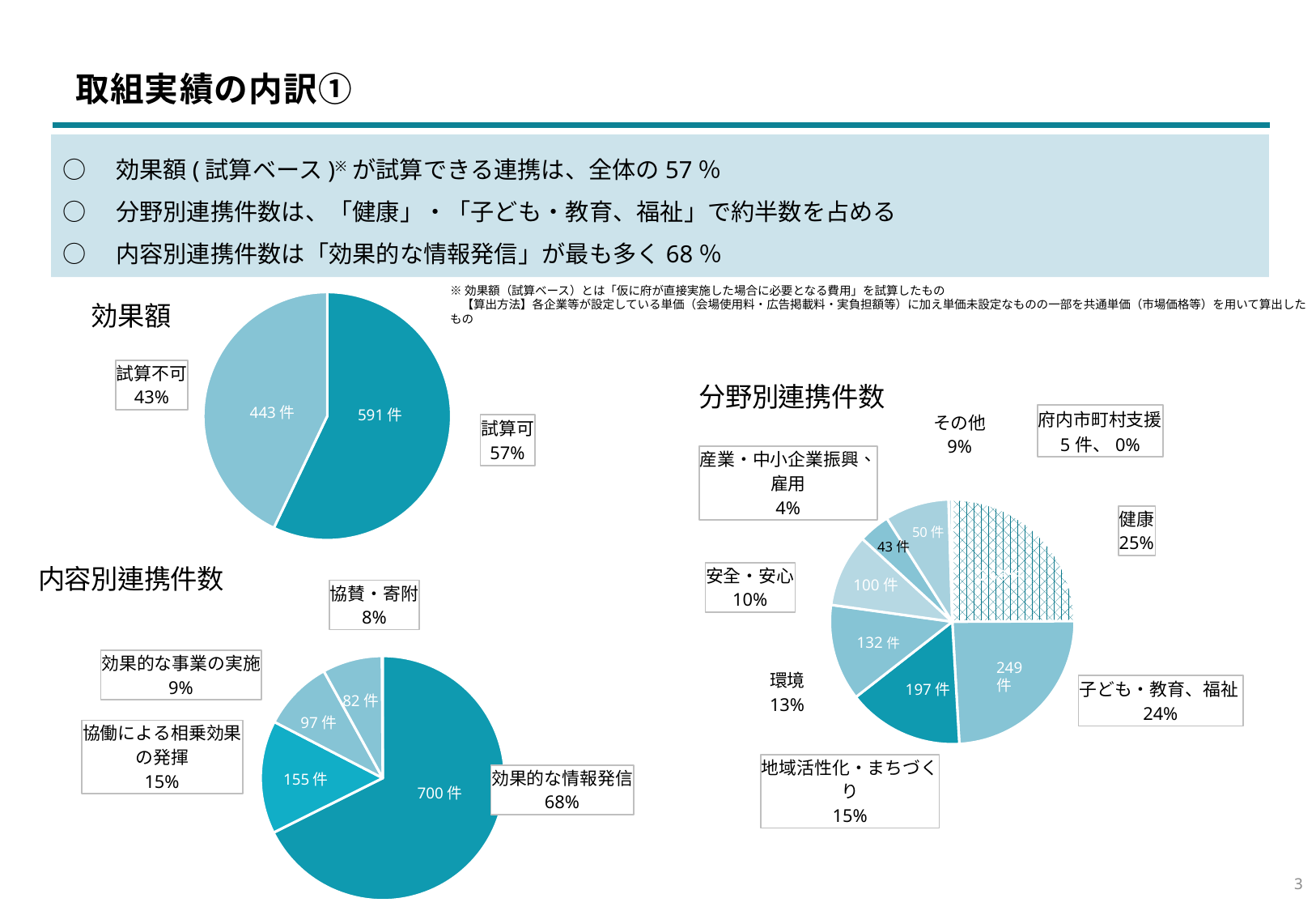
In the 内容別連携件数 chart, how many 件 are shown for 効果的な情報発信? 700 件 In the 内容別連携件数 chart, what percentage share does 協働による相乗効果の発揮 have? 15% In the 効果額 chart, how many 件 are shown for 試算可? 591 件 What type of chart is the 効果額 chart? pie chart In the 分野別連携件数 chart, how many 件 are shown for 子ども・教育、福祉? 249 件 In the 効果額 chart, what is the difference in 件 between 試算可 and 試算不可? 148 件 In the 分野別連携件数 chart, what is the difference in 件 between 地域活性化・まちづくり and 環境? 65 件 In the 内容別連携件数 chart, how many categories are shown? 4 In the 効果額 chart, what percentage share does 試算不可 have? 43% In the 内容別連携件数 chart, which category has the smallest share? 協賛・寄附 In the 分野別連携件数 chart, which category has the largest share? 健康 In the 分野別連携件数 chart, which is larger, 環境 or 安全・安心? 環境